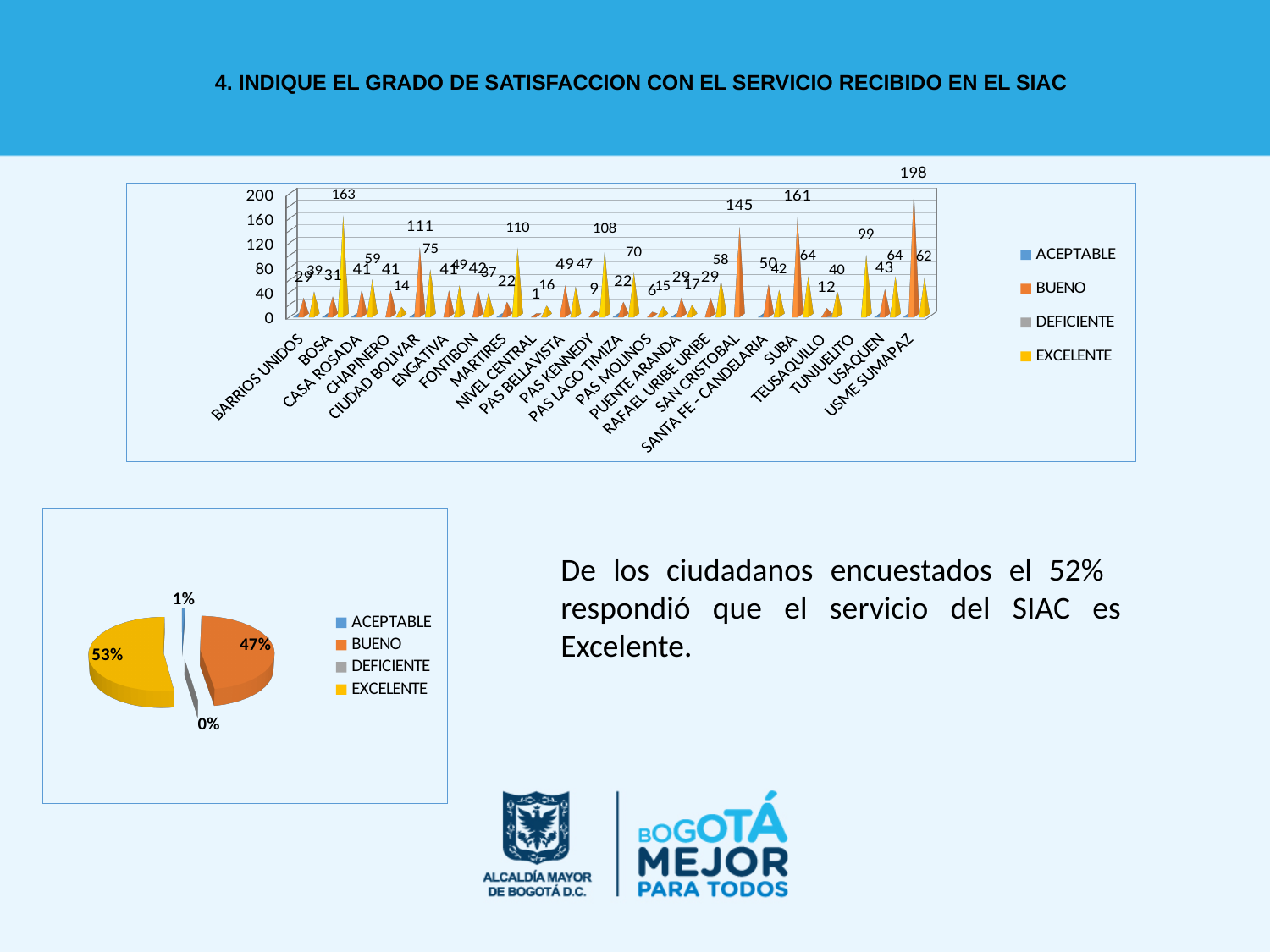
In the pie chart at the bottom left, which category has the largest slice? EXCELENTE What kind of chart is the chart at the bottom left of the slide? Pie chart In the pie chart at the bottom left, what percentage does the EXCELENTE slice represent? 53% In the pie chart at the bottom left, by how many percentage points does EXCELENTE exceed BUENO? 6 percentage points In the pie chart at the bottom left, which category has the smallest slice? DEFICIENTE How many series does the legend of the pie chart at the bottom left list? 4 In the pie chart at the bottom left, what percentage does the BUENO slice represent? 47% In the pie chart at the bottom left, what percentage is shown for DEFICIENTE? 0% In the pie chart at the bottom left, what percentage is shown for ACEPTABLE? 1% In the top chart, what is the highest value labeled, and for which category? 198, USME SUMAPAZ What kind of chart is the chart at the top of the slide? Bar chart In the top chart, how many categories are shown along the x axis? 22